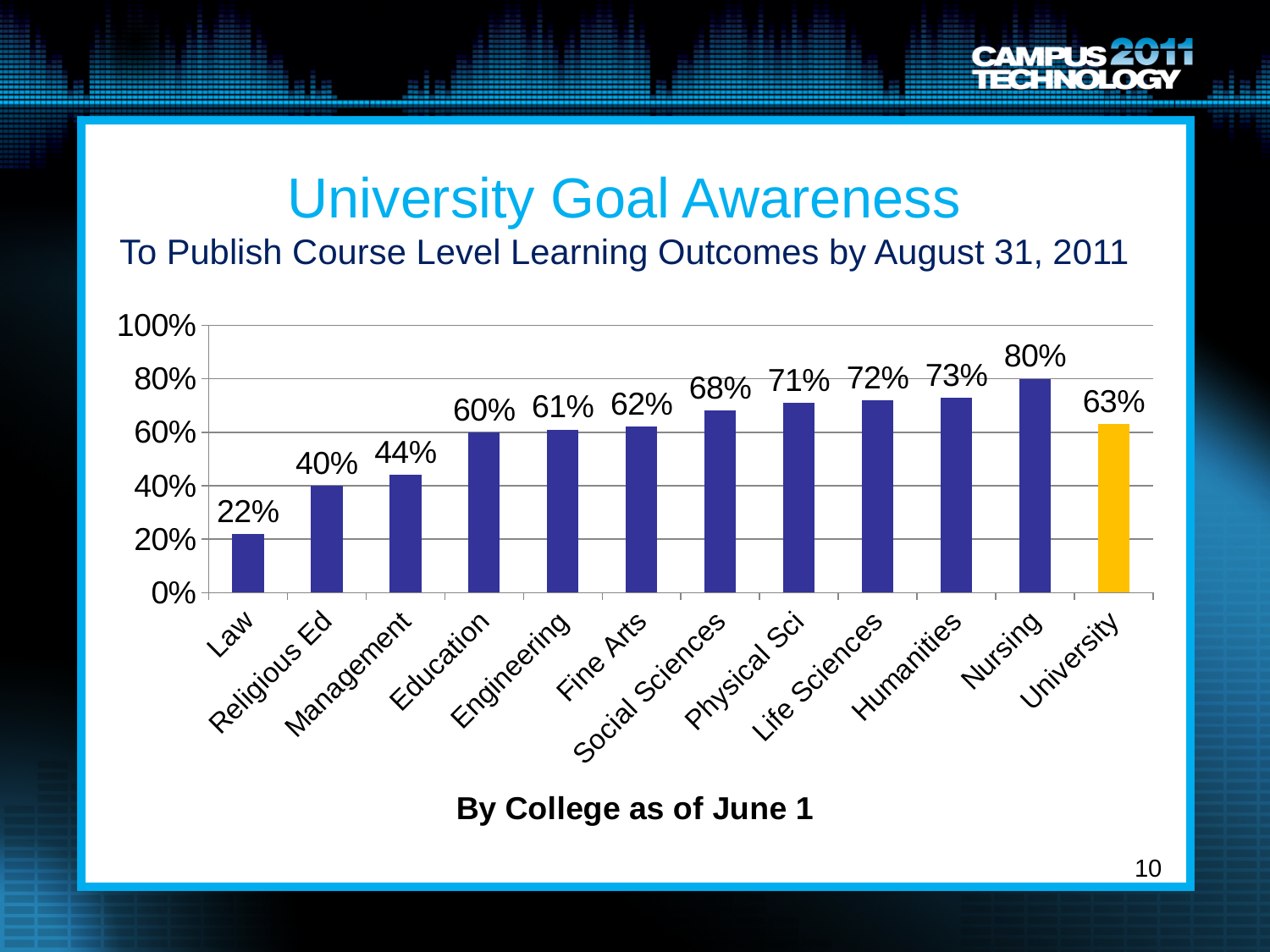
Which category has the lowest value? Law How many categories are shown on the x axis? 12 What is the value for Social Sciences? 68% What is the value for Nursing? 80% Which is larger, the value for Management or the value for Education? Education Which category has the highest value? Nursing What kind of chart is shown? Bar chart What is the value for Law? 22% Which bar is coloured differently (yellow) from the others? University What is the value for University? 63% What is the difference between the values for Nursing and Law? 58% Do the values rise or fall from Law to Nursing along the x axis? Rise